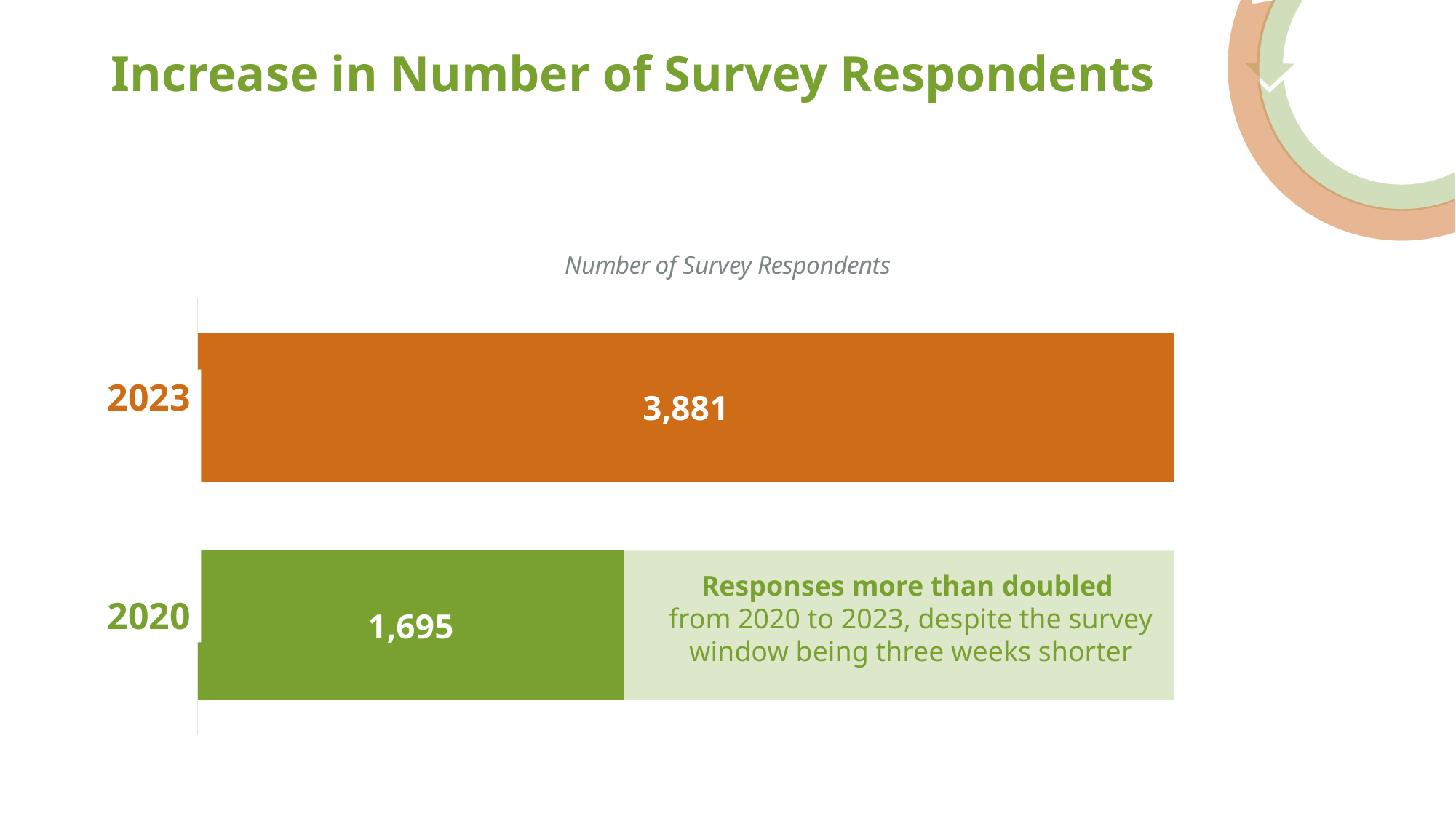
What is the number of survey respondents for 2023? 3,881 What is the number of survey respondents for 2020? 1,695 What is the difference in survey respondents between 2023 and 2020? 2,186 Which year has the lower number of survey respondents? 2020 What kind of chart is shown on the slide? Bar chart How many years (categories) are shown in the chart? 2 What colour is the bar for 2023? Orange Which year has the higher number of survey respondents? 2023 Is the number of respondents larger in 2020 or in 2023? 2023 What is the title of the chart? Number of Survey Respondents